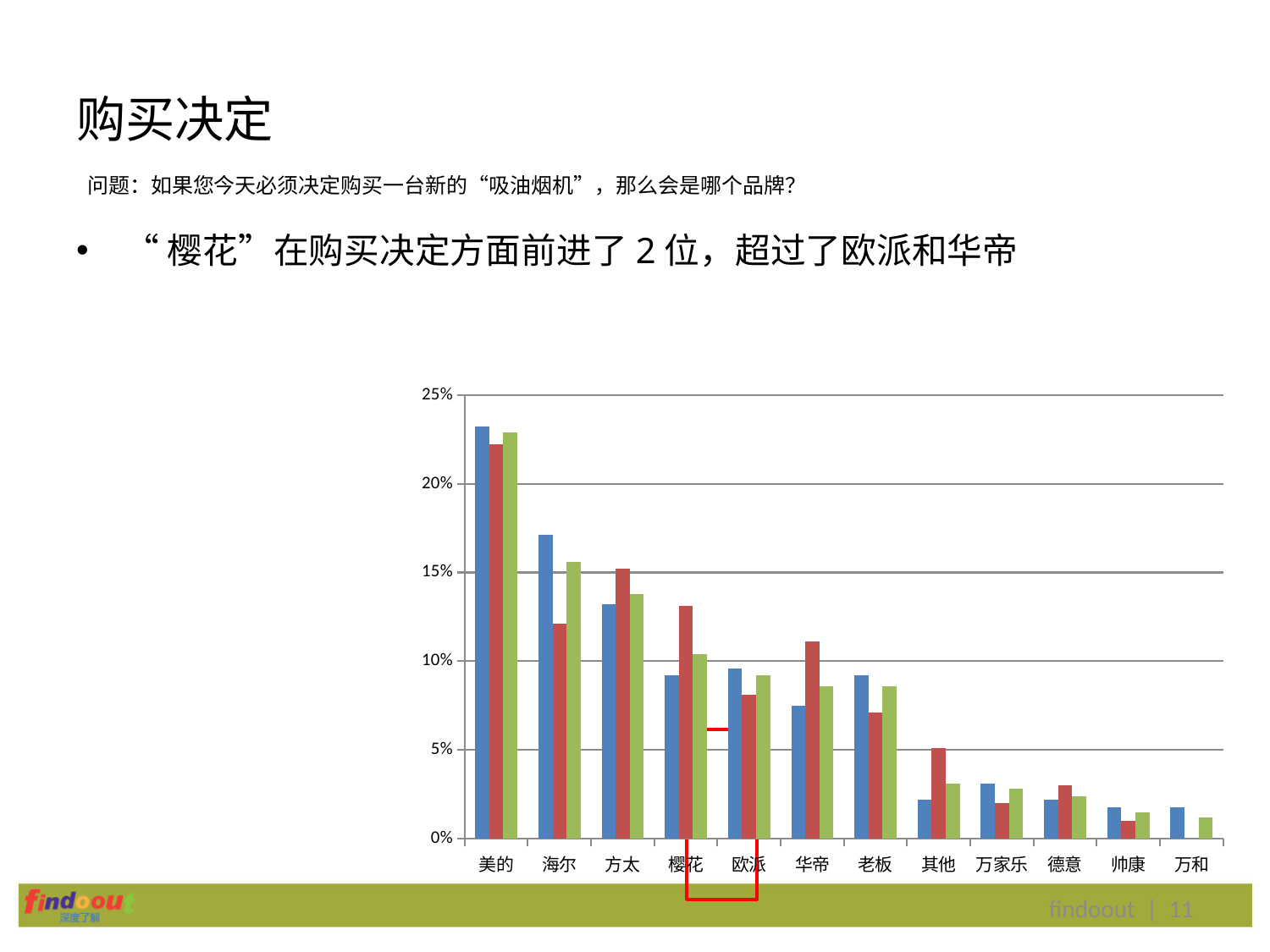
Is the blue bar for 万和 greater or less than 5%? less How many brand categories are shown on the x axis of the chart? 12 Is the red bar for 欧派 greater or less than 10%? less Is the blue bar for 美的 greater or less than 20%? greater What kind of chart is shown on the slide? bar chart Do the bar heights generally rise or fall moving from left to right along the x axis? fall Which category has the tallest bars in the chart? 美的 Which two categories are enclosed by the red box on the chart? 樱花 and 欧派 Which has the larger blue bar, 海尔 or 方太? 海尔 Which has the larger red bar, 樱花 or 欧派? 樱花